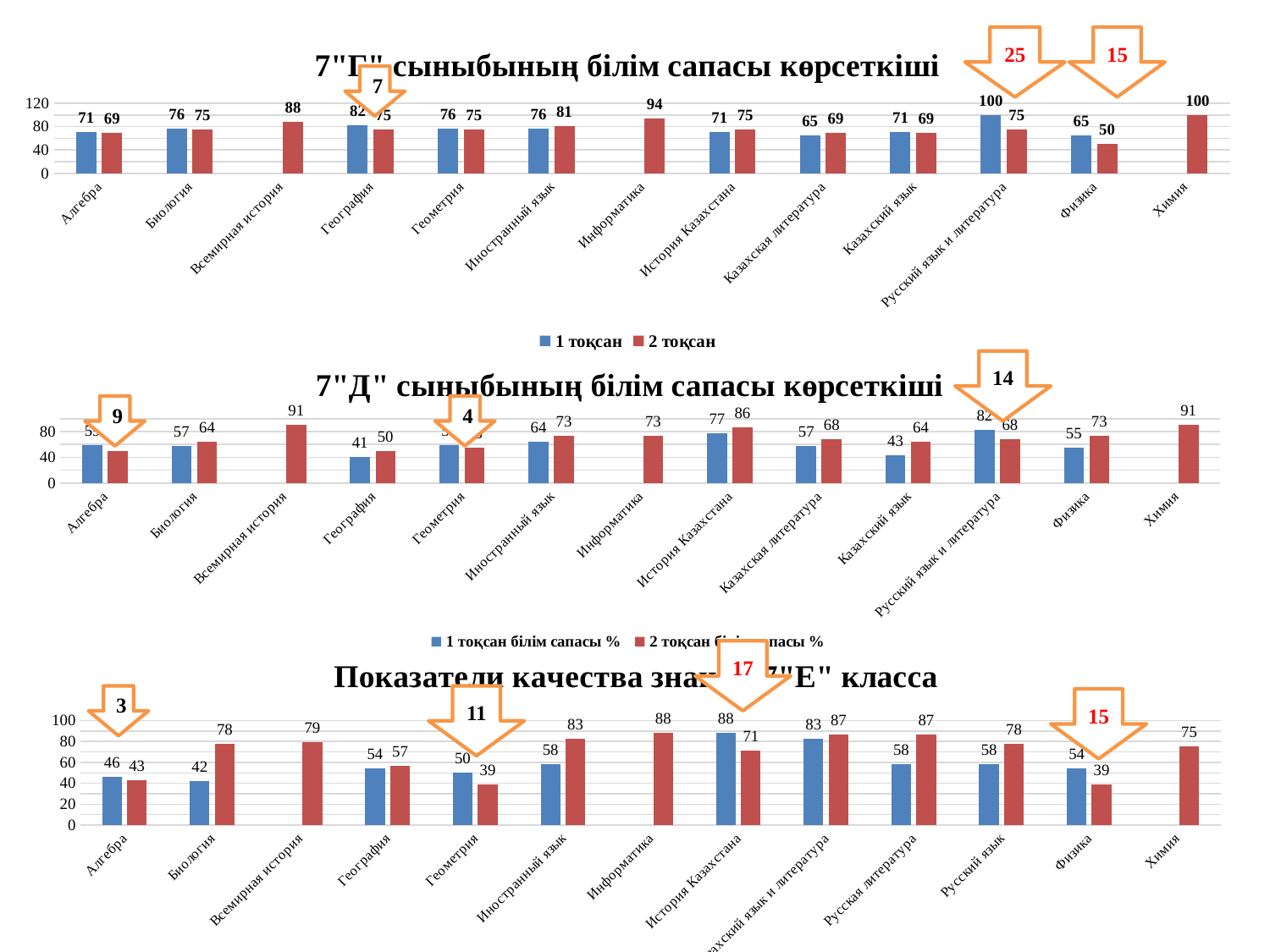
In the top chart (7"Г"), how many series does the legend list? 2 What type of chart is the bottom chart (7"Е")? Bar chart In the bottom chart (7"Е"), how many subject categories are shown on the x axis? 13 In the top chart (7"Г"), what is the value for Физика in 2 тоқсан? 50 In the middle chart (7"Д"), what is the value for История Казахстана in the second series? 86 In the top chart (7"Г"), what is the difference between the 1 тоқсан and 2 тоқсан values for Физика? 15 In the middle chart (7"Д"), what is the difference between the two series values for Русский язык и литература? 14 In the top chart (7"Г"), what is the value for Русский язык и литература in 1 тоқсан? 100 In the top chart (7"Г"), which is larger for Иностранный язык: 1 тоқсан or 2 тоқсан? 2 тоқсан In the bottom chart (7"Е"), what is the value for Биология in the second series? 78 In the middle chart (7"Д"), what is the value for Казахский язык in the first series? 43 In the bottom chart (7"Е"), what is the difference between the two series values for Геометрия? 11